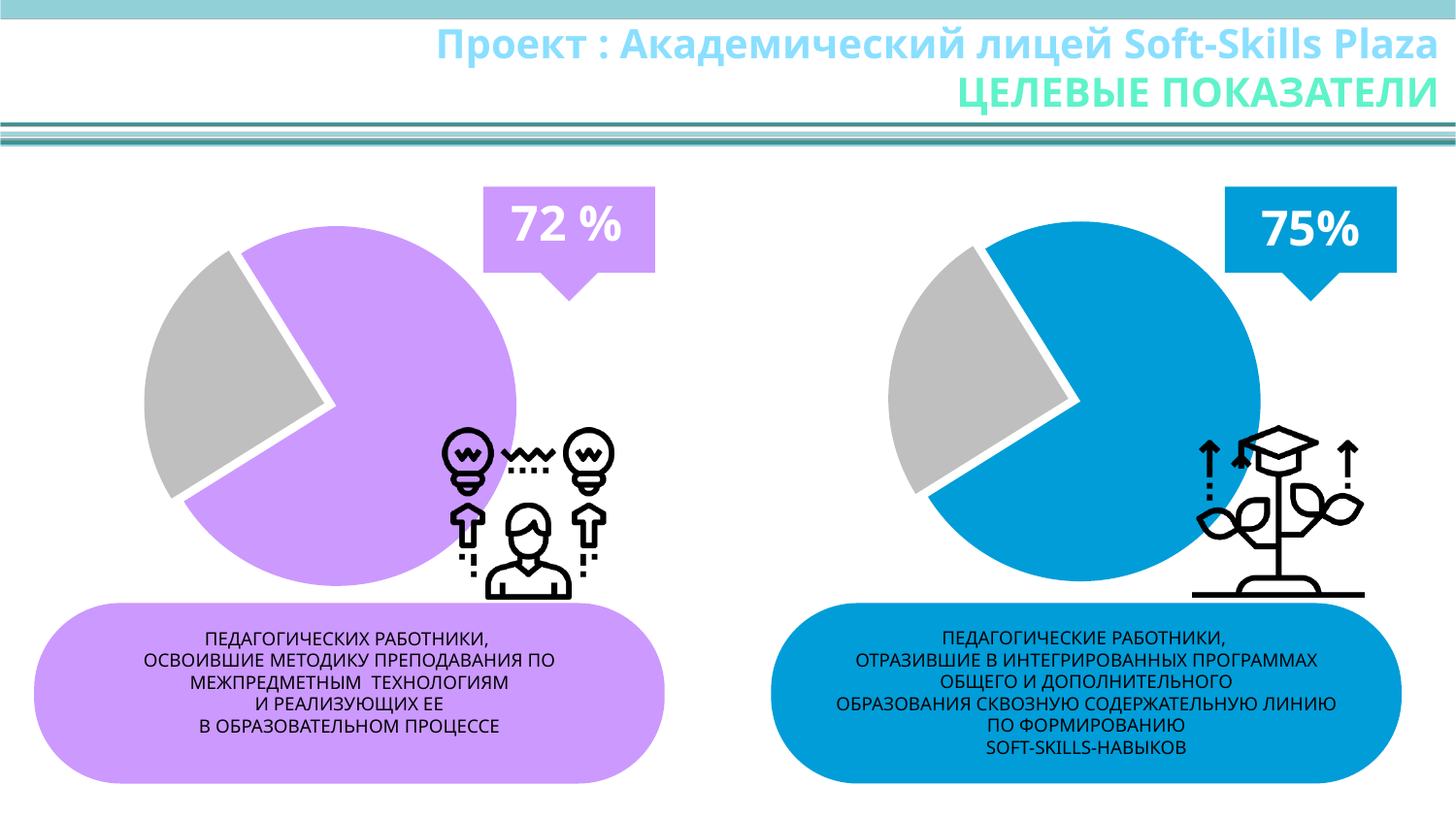
What is the difference in percentage points between the right pie chart's value (75%) and the left pie chart's value (72 %)? 3 percentage points On the right pie chart, is the grey slice greater or less than 50%? less What kind of chart is used on the left side of the slide? Pie chart What kind of chart is used on the right side of the slide? Pie chart What colour is the highlighted slice in the right pie chart? Blue How many pie charts are on the slide? 2 What colour is the highlighted slice in the left pie chart? Purple On the left pie chart, what percentage is shown for teaching staff who have mastered the interdisciplinary teaching methodology? 72 % Which chart shows the larger highlighted share, the left pie chart (72 %) or the right pie chart (75%)? The right pie chart On the left pie chart, is the highlighted share greater or less than 50%? greater On the right pie chart, what percentage is shown for teaching staff who included a soft-skills content line in integrated programmes? 75% How many slices does each pie chart on the slide have? 2